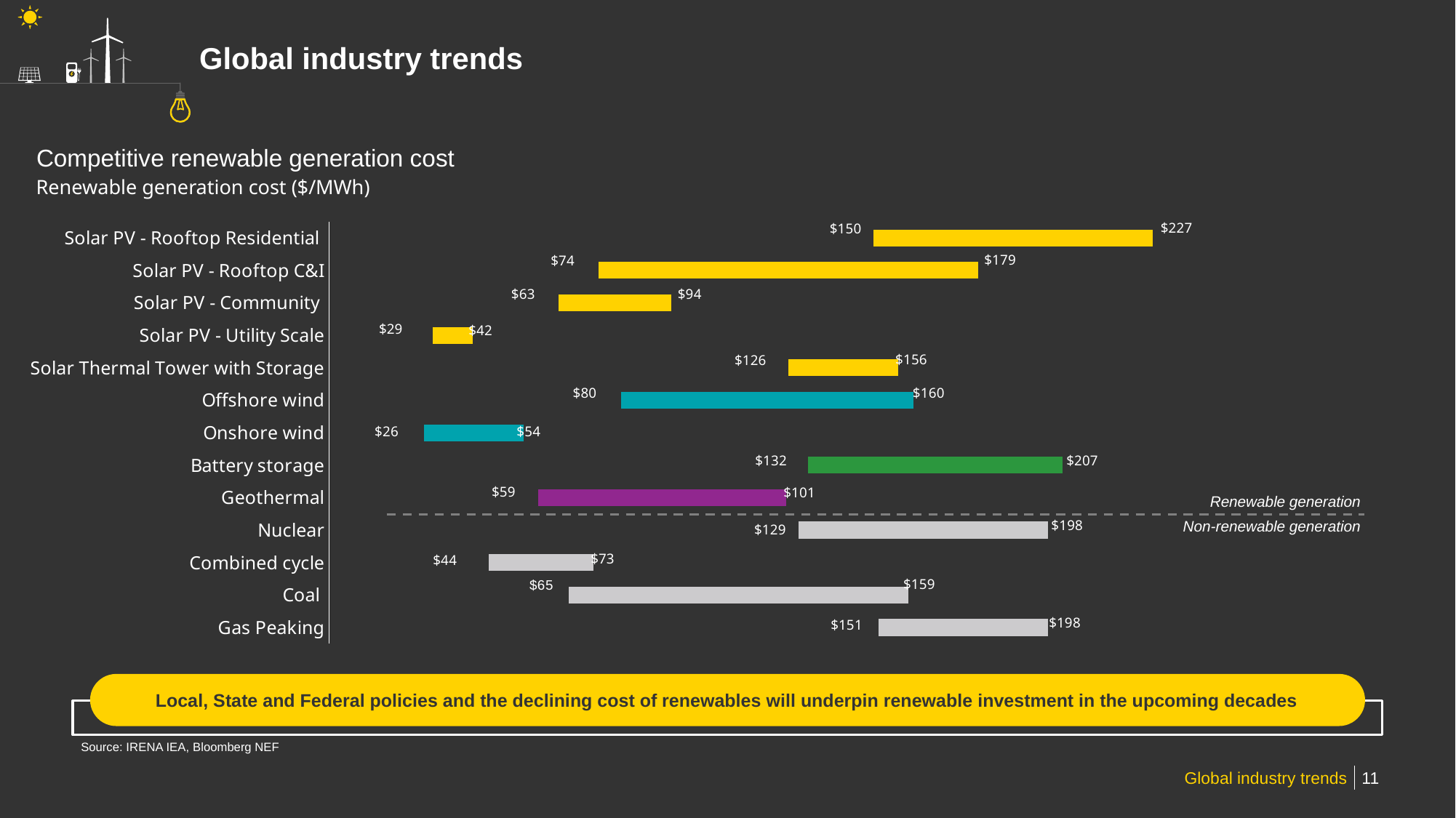
What is the high end of the cost range for Coal? $159 What is the difference between the upper cost values of Nuclear and Geothermal? $97 What is the low end of the cost range for Onshore wind? $26 Which category has the lowest lower cost value on the chart? Onshore wind What is the high end of the renewable generation cost range for Solar PV - Rooftop Residential? $227 How many categories are shown on the chart? 13 What kind of chart is shown on the slide? Bar chart What is the cost range shown for Battery storage? $132 to $207 What unit is the renewable generation cost measured in, according to the chart subtitle? $/MWh Which category has the highest upper cost value on the chart? Solar PV - Rooftop Residential What is the difference between the high and low ends of the cost range for Solar PV - Utility Scale? $13 Which has a higher upper cost value, Offshore wind or Solar Thermal Tower with Storage? Offshore wind